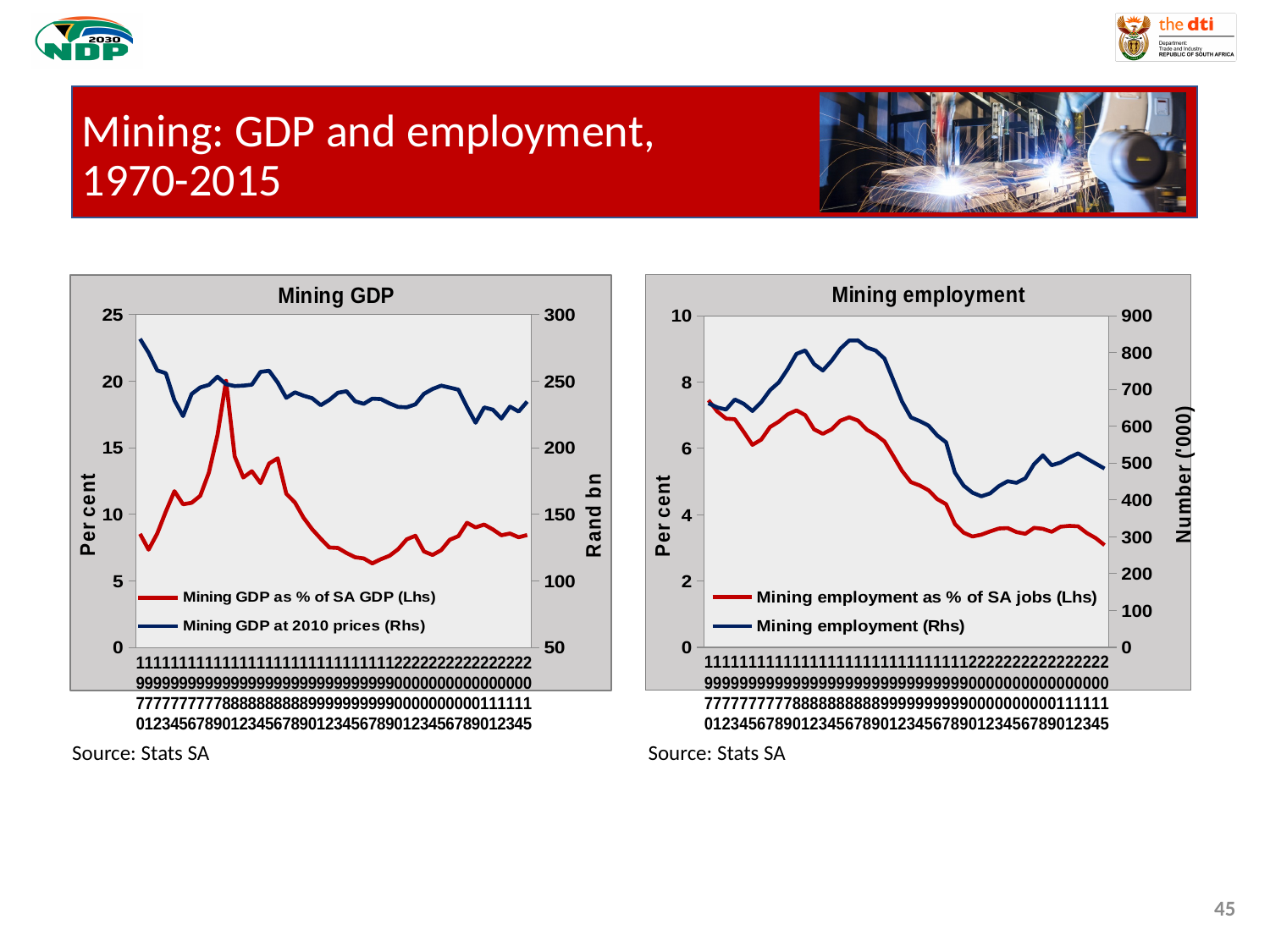
In the "Mining employment" chart, is the value of Mining employment (Rhs) in 2015 greater or less than 600? less How many series does the legend of the "Mining employment" chart list? 2 In the "Mining employment" chart, is the value of Mining employment as % of SA jobs in 2015 greater or less than 4? less In the "Mining employment" chart, does Mining employment as % of SA jobs overall rise or fall from 1970 to 2015? Fall What kind of chart is the "Mining employment" chart? Line chart What kind of chart is the "Mining GDP" chart? Line chart In the "Mining GDP" chart, is the value of Mining GDP as % of SA GDP in 1970 greater or less than 5? greater In the "Mining employment" chart, what is the title of the right-hand vertical axis? Number ('000) How many series does the legend of the "Mining GDP" chart list? 2 In the "Mining GDP" chart, what is the title of the right-hand vertical axis? Rand bn